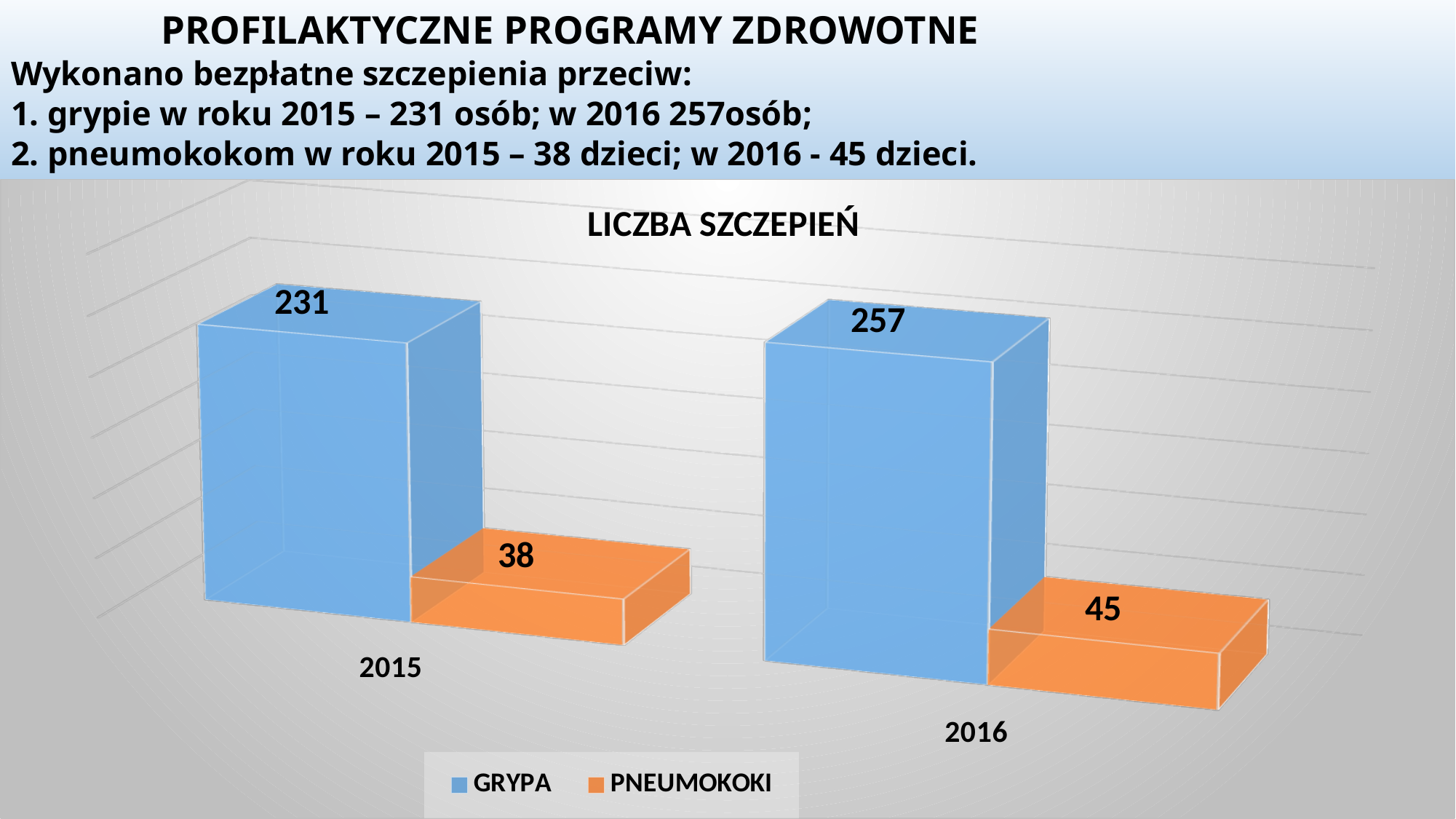
How many series does the legend list? 2 Which is larger in 2015: GRYPA or PNEUMOKOKI? GRYPA What is the value for PNEUMOKOKI in 2016? 45 Which year has the lower value for PNEUMOKOKI? 2015 What is the value for PNEUMOKOKI in 2015? 38 What is the value for GRYPA in 2015? 231 What is the difference between the GRYPA values for 2016 and 2015? 26 What is the difference between the PNEUMOKOKI values for 2016 and 2015? 7 What is the value for GRYPA in 2016? 257 What is the title of the chart? LICZBA SZCZEPIEŃ What kind of chart is shown? bar chart Which year has the higher value for GRYPA? 2016